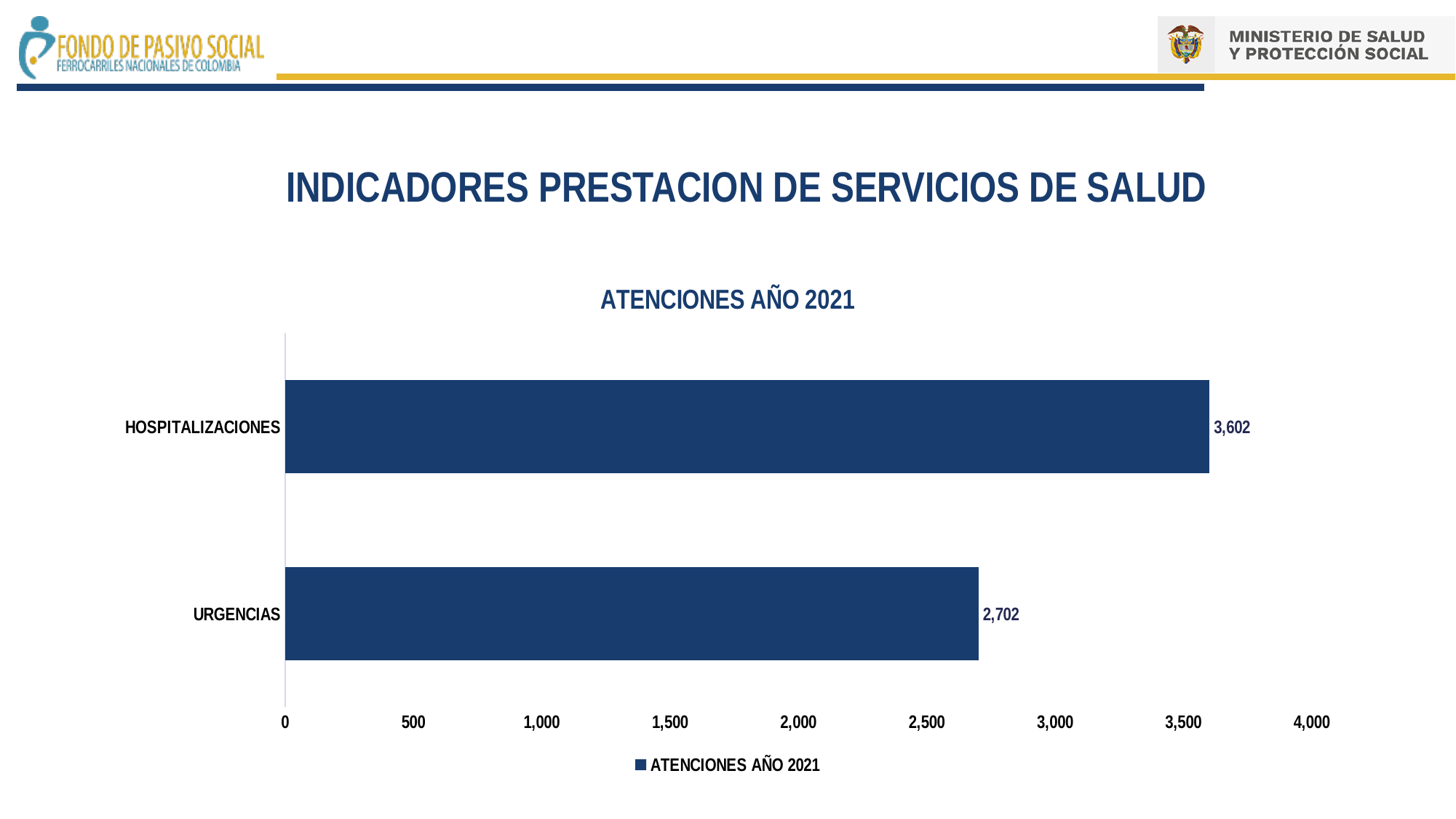
Which is larger, the value for HOSPITALIZACIONES or the value for URGENCIAS? HOSPITALIZACIONES What is the title of the chart? ATENCIONES AÑO 2021 How many categories are shown in the chart? 2 What is the value for URGENCIAS? 2,702 What is the value for HOSPITALIZACIONES? 3,602 How many series does the legend list? 1 What is the difference between the values for HOSPITALIZACIONES and URGENCIAS? 900 Is the value for HOSPITALIZACIONES greater or less than 3,500? greater Which category has the highest value? HOSPITALIZACIONES Is the value for URGENCIAS greater or less than 3,000? less What kind of chart is shown? bar chart Which category has the lowest value? URGENCIAS